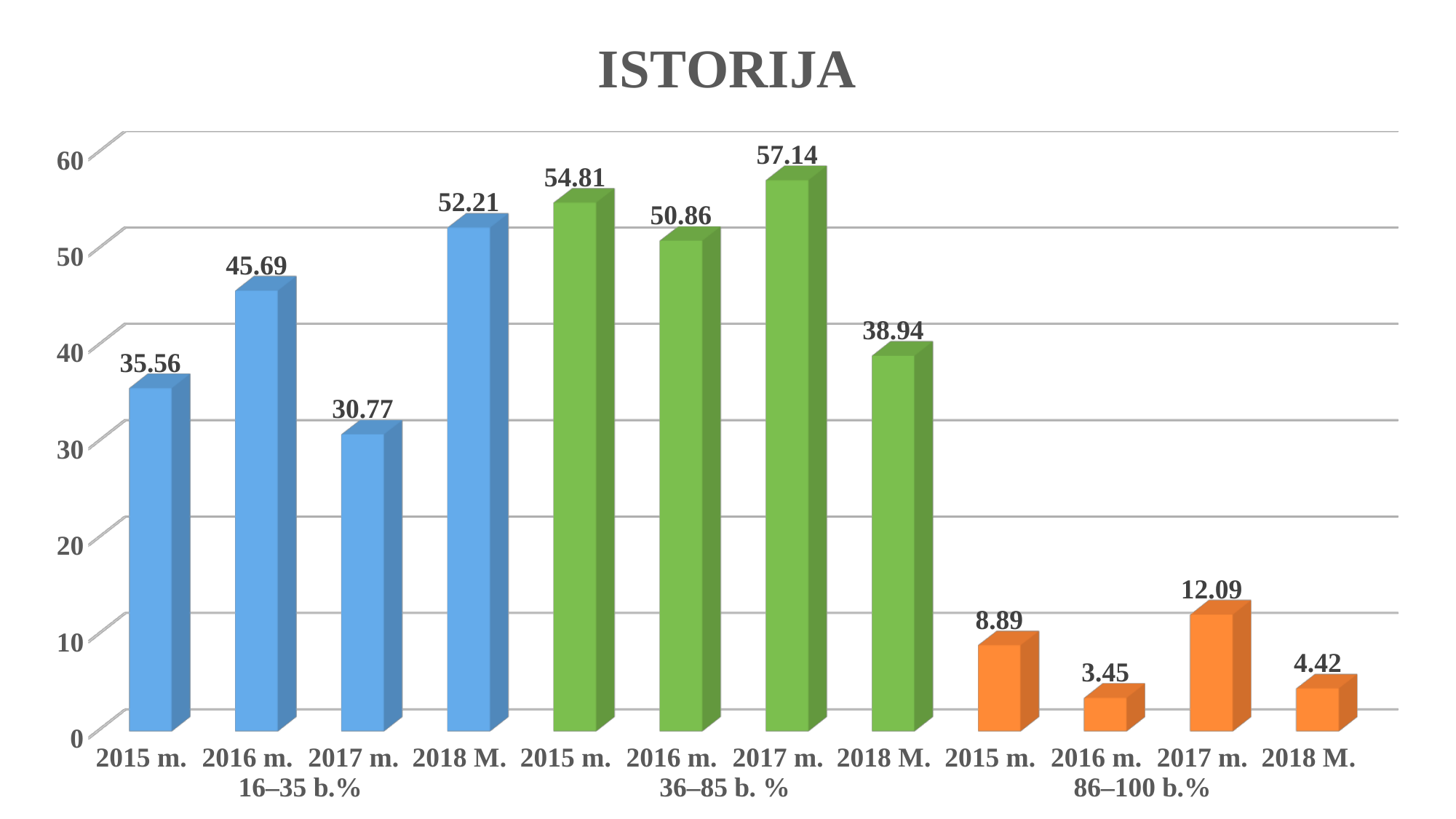
Which is larger: the 2015 m. value in the 16–35 b.% group or the 2015 m. value in the 36–85 b. % group? 2015 m. in the 36–85 b. % group (54.81) How many groups of categories are shown along the x axis? 3 What is the title of the chart? ISTORIJA What type of chart is shown on the slide? bar chart What is the value for 2017 m. in the 16–35 b.% group? 30.77 What is the difference between the 2018 M. and 2017 m. values in the 16–35 b.% group? 21.44 What is the difference between the 2017 m. and 2018 M. values in the 86–100 b.% group? 7.67 How many bars are plotted in the chart? 12 Which bar has the highest value in the chart? 2017 m. in the 36–85 b. % group (57.14) Which bar has the lowest value in the chart? 2016 m. in the 86–100 b.% group (3.45) What is the value for 2018 M. in the 36–85 b. % group? 38.94 What is the value for 2016 m. in the 86–100 b.% group? 3.45